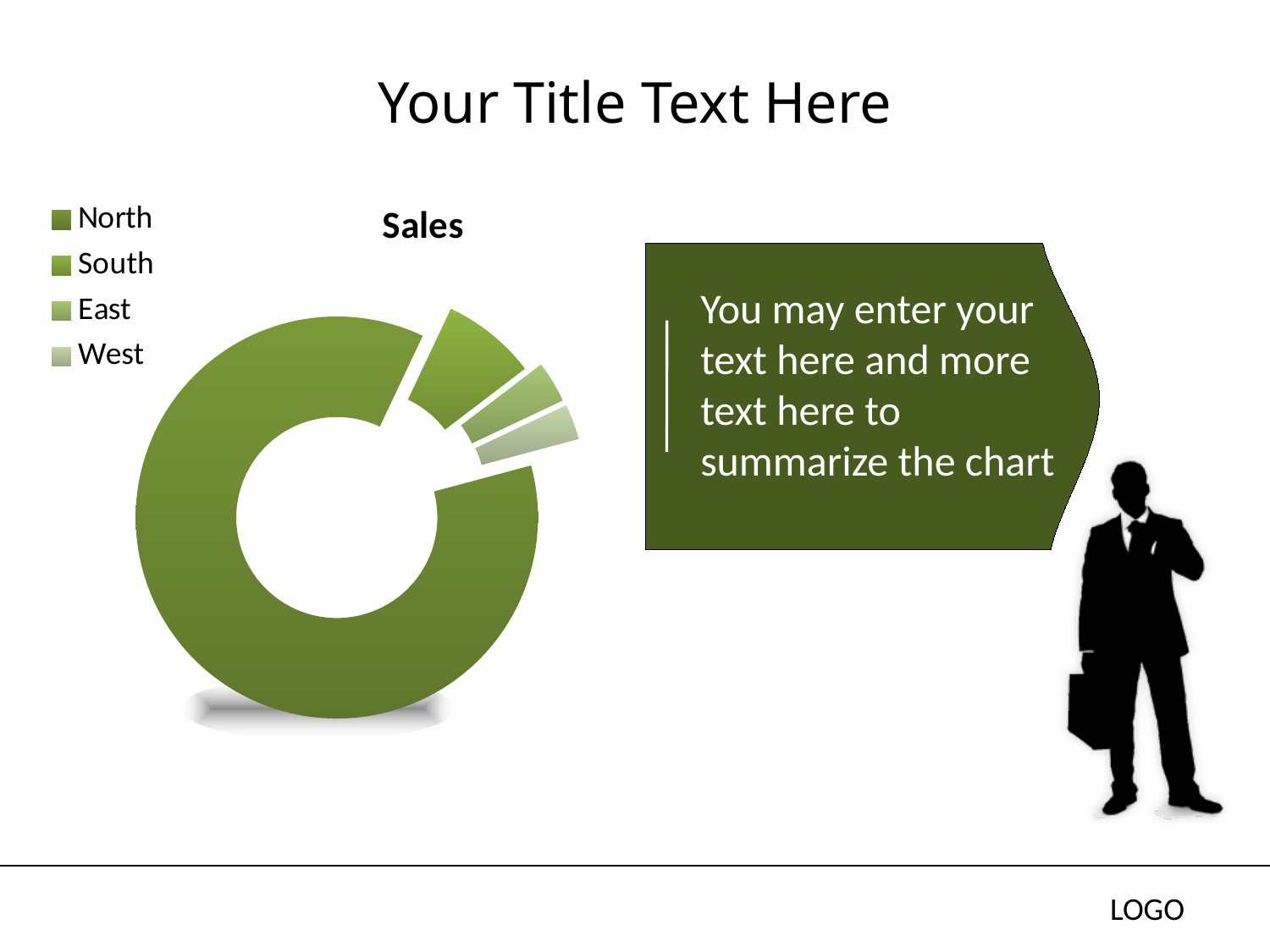
Which category is listed first in the chart's legend? North Which category has the largest share of the Sales chart? North Which is larger in the Sales chart, South or East? South Which is larger in the Sales chart, North or South? North Does the North slice take up more or less than half of the Sales chart? more Which is larger in the Sales chart, South or West? South What is the title of the chart? Sales How many categories does the chart's legend list? 4 What kind of chart is shown on the slide? doughnut chart